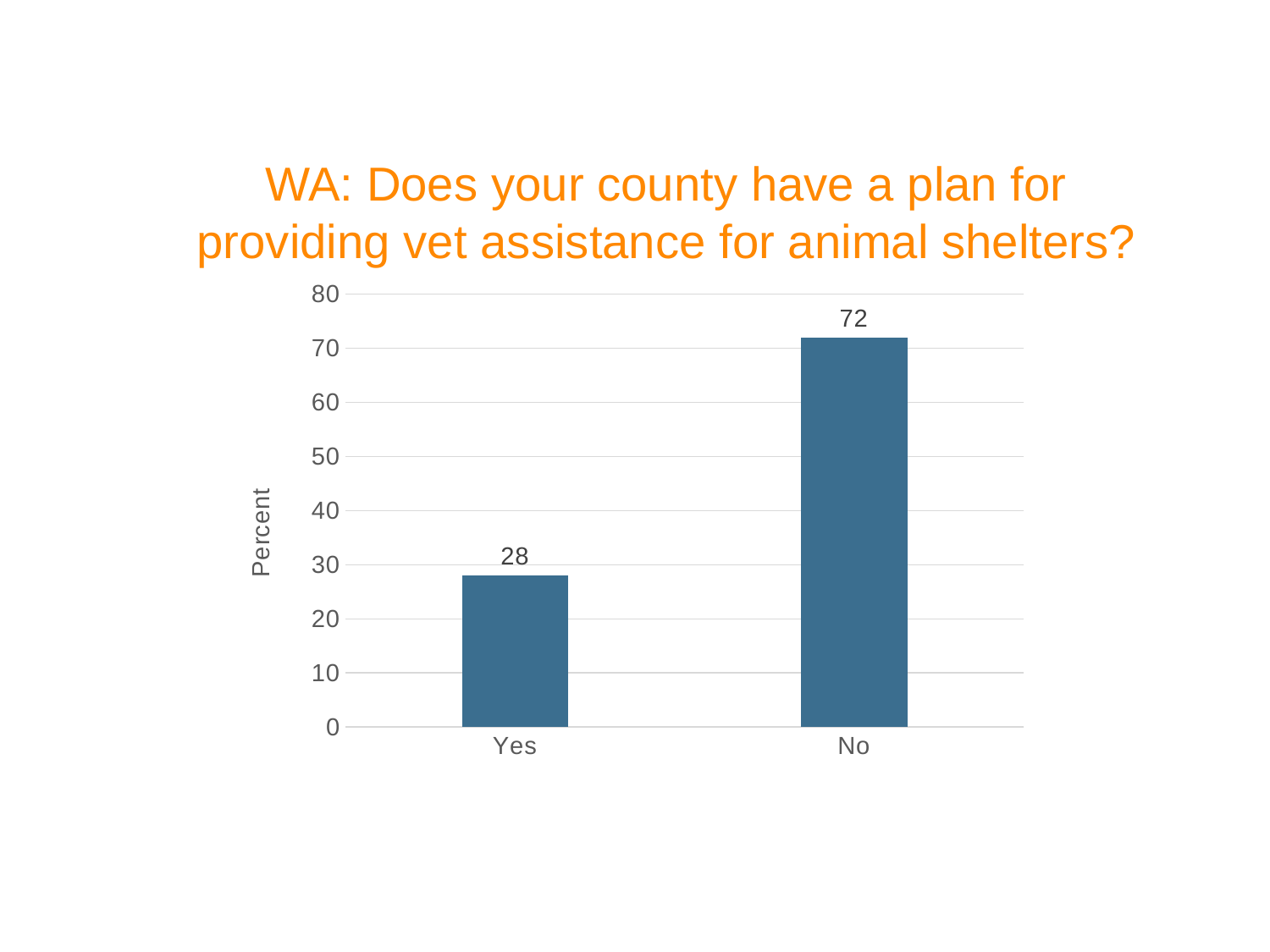
What is the value for No? 72 Is the value for No greater or less than 70? greater What is the label of the vertical axis? Percent Which is larger, the value for Yes or the value for No? No How many categories are shown on the x axis? 2 What is the difference between the values for No and Yes? 44 Is the value for Yes greater or less than 30? less Which category has the lowest value? Yes Which category has the highest value? No What kind of chart is shown on the slide? bar chart What is the title of the chart? WA: Does your county have a plan for providing vet assistance for animal shelters? What is the value for Yes? 28